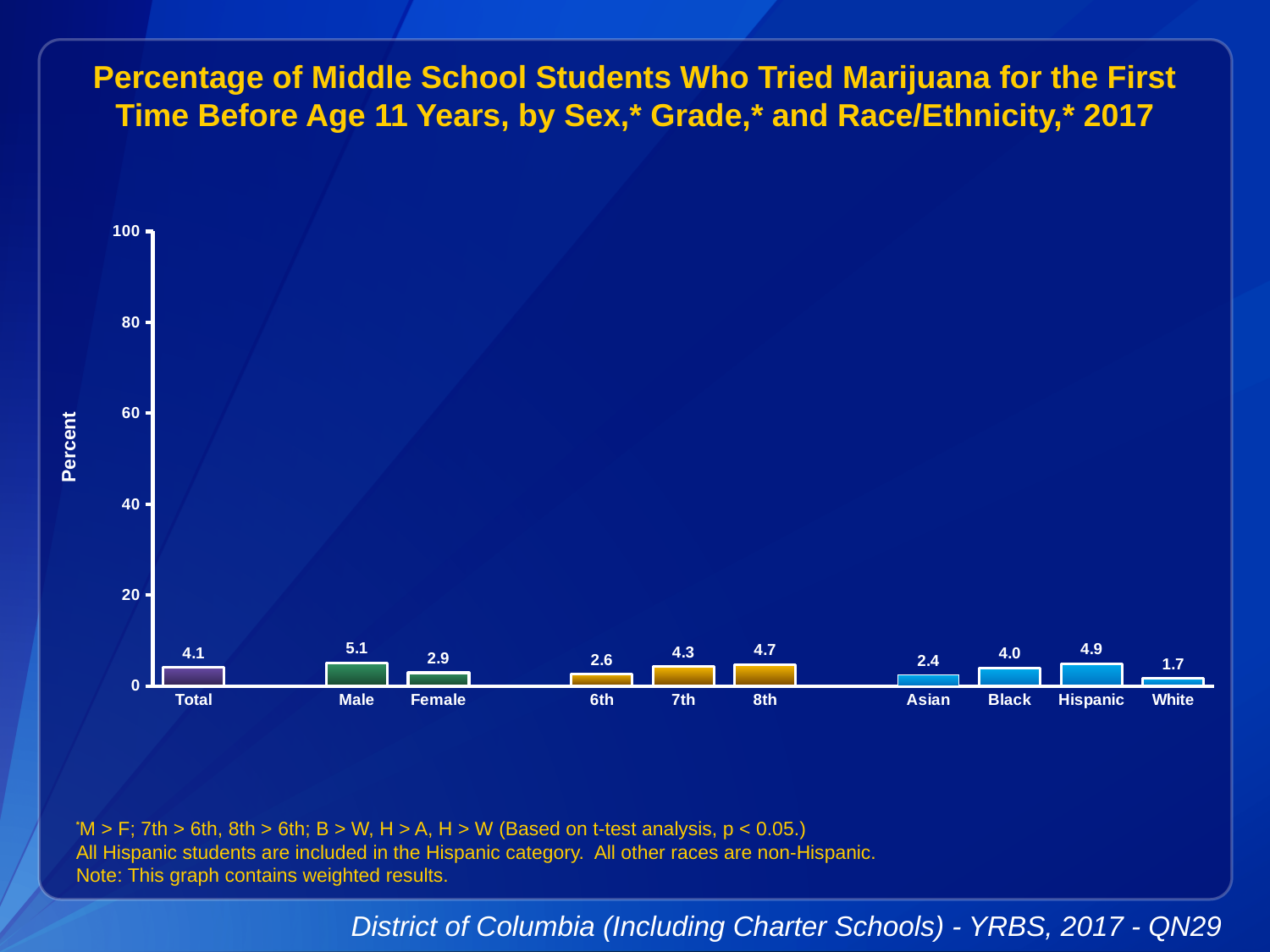
Is the value for Black greater or less than 20? less What is the value for Total? 4.1 What is the difference between the values for Male and Female? 2.2 What is the value for Male? 5.1 What is the label on the y axis? Percent Do the values rise or fall from 6th to 8th grade? rise What is the value for Hispanic? 4.9 Which category has the highest value? Male Which is larger, the value for 8th or the value for 6th? 8th Which category has the lowest value? White What kind of chart is this? bar chart How many categories are shown on the x axis? 10